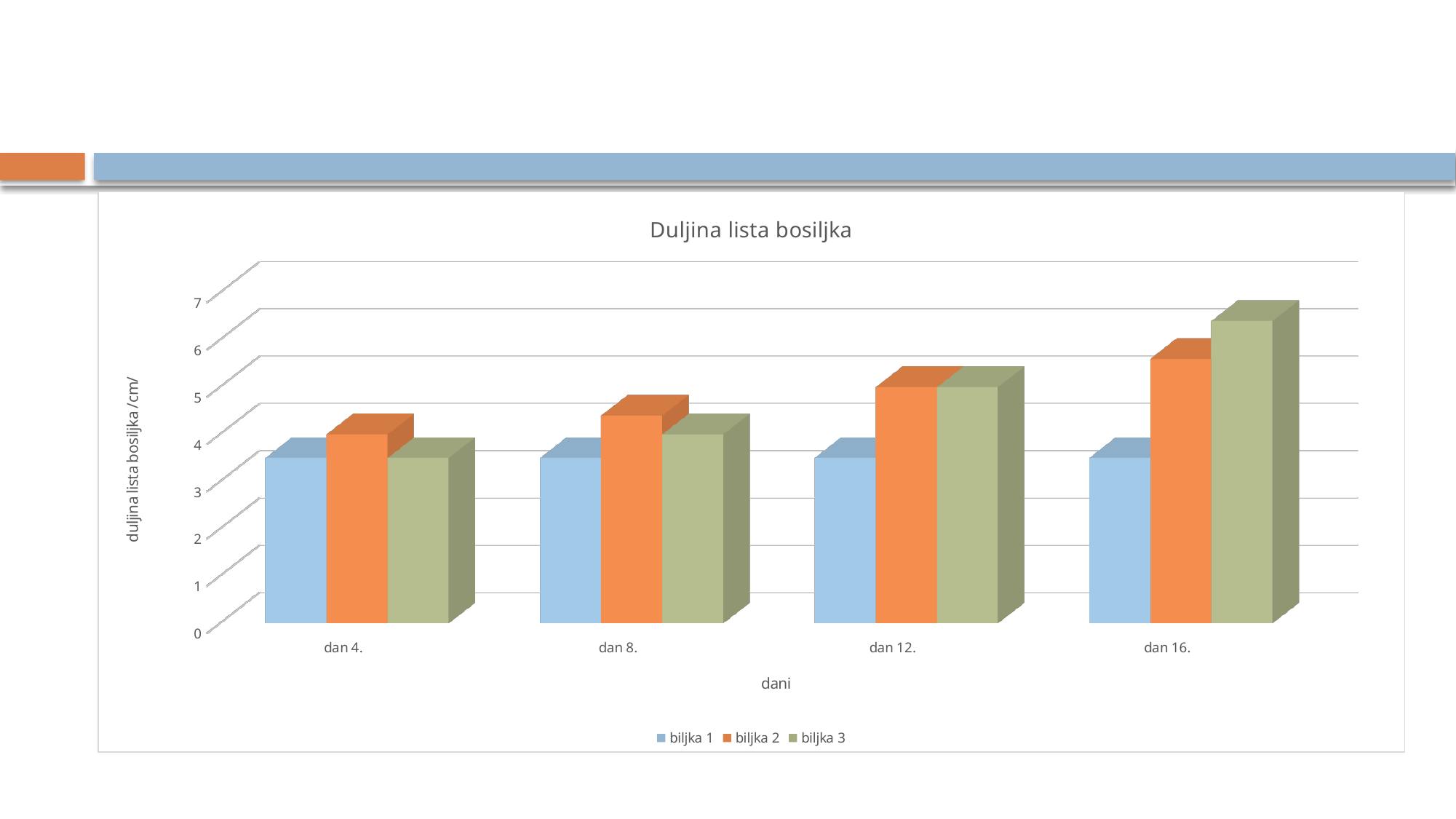
Is the value for biljka 1 at dan 4. greater or less than 4? less What kind of chart is shown on the slide? bar chart What is the label of the vertical axis? duljina lista bosiljka /cm/ Is the value for biljka 3 at dan 16. greater or less than 5? greater Is the value for biljka 2 at dan 16. greater or less than 5? greater Do the values for biljka 3 rise or fall from dan 4. to dan 16.? rise How many series does the legend list? 3 Which series has the highest bar at dan 16.? biljka 3 How many categories are shown on the x axis? 4 At dan 4., which is larger: biljka 1 or biljka 2? biljka 2 What is the title of the chart? Duljina lista bosiljka